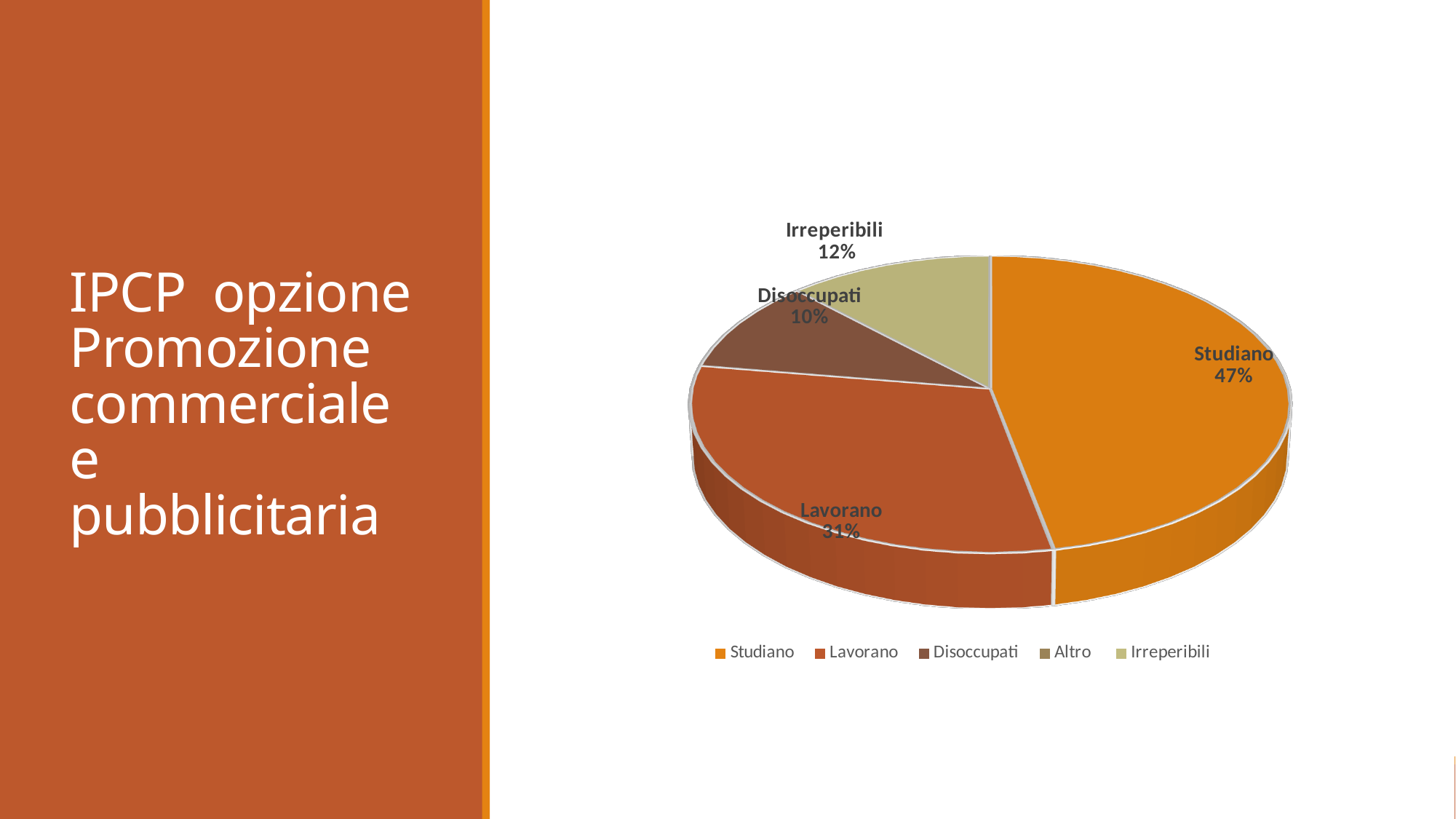
Which is larger, the share for Irreperibili or the share for Disoccupati? Irreperibili What is the difference in percentage points between Studiano and Lavorano? 16 Which category has the largest slice of the pie? Studiano What kind of chart is shown on the slide? pie chart What percentage of the pie is labelled Lavorano? 31% Which legend entry does not have a labelled slice visible in the pie? Altro What colour is the Studiano slice? orange What percentage of the pie is labelled Irreperibili? 12% What percentage of the pie is labelled Studiano? 47% What percentage of the pie is labelled Disoccupati? 10% Among the slices with printed labels, which category has the smallest share? Disoccupati How many entries does the legend list? 5